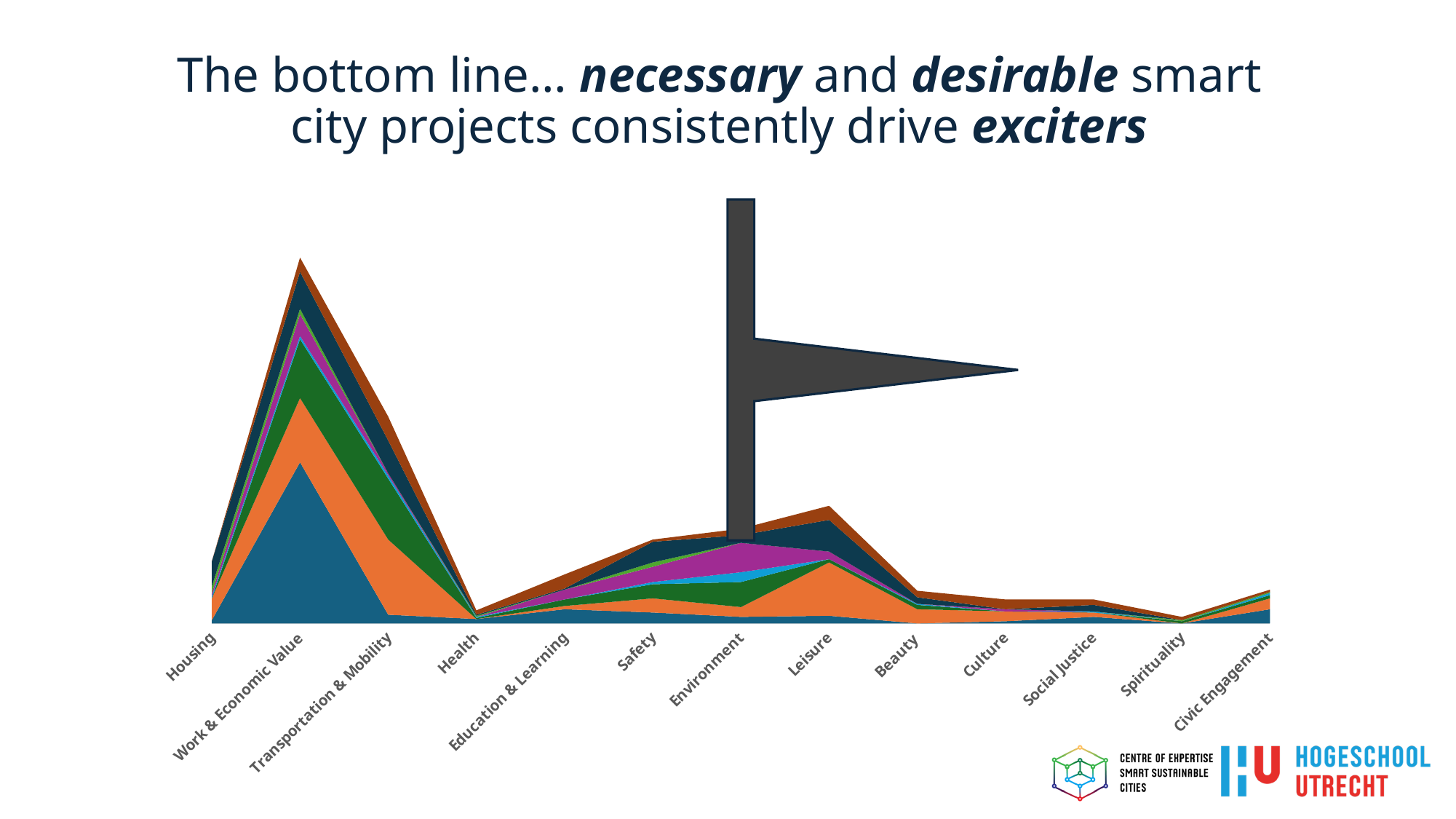
Which category has the highest total value in the chart? Work & Economic Value What is the last category on the x axis of the chart? Civic Engagement Which is larger in the chart, the total for Leisure or the total for Culture? Leisure How many categories are shown along the x axis of the chart? 13 What is the first category on the x axis of the chart? Housing Which is larger in the chart, the total for Housing or the total for Health? Housing What kind of chart is shown on the slide? Stacked area chart Above which category is the flag marker placed on the chart? Environment Which is larger in the chart, the total for Transportation & Mobility or the total for Beauty? Transportation & Mobility